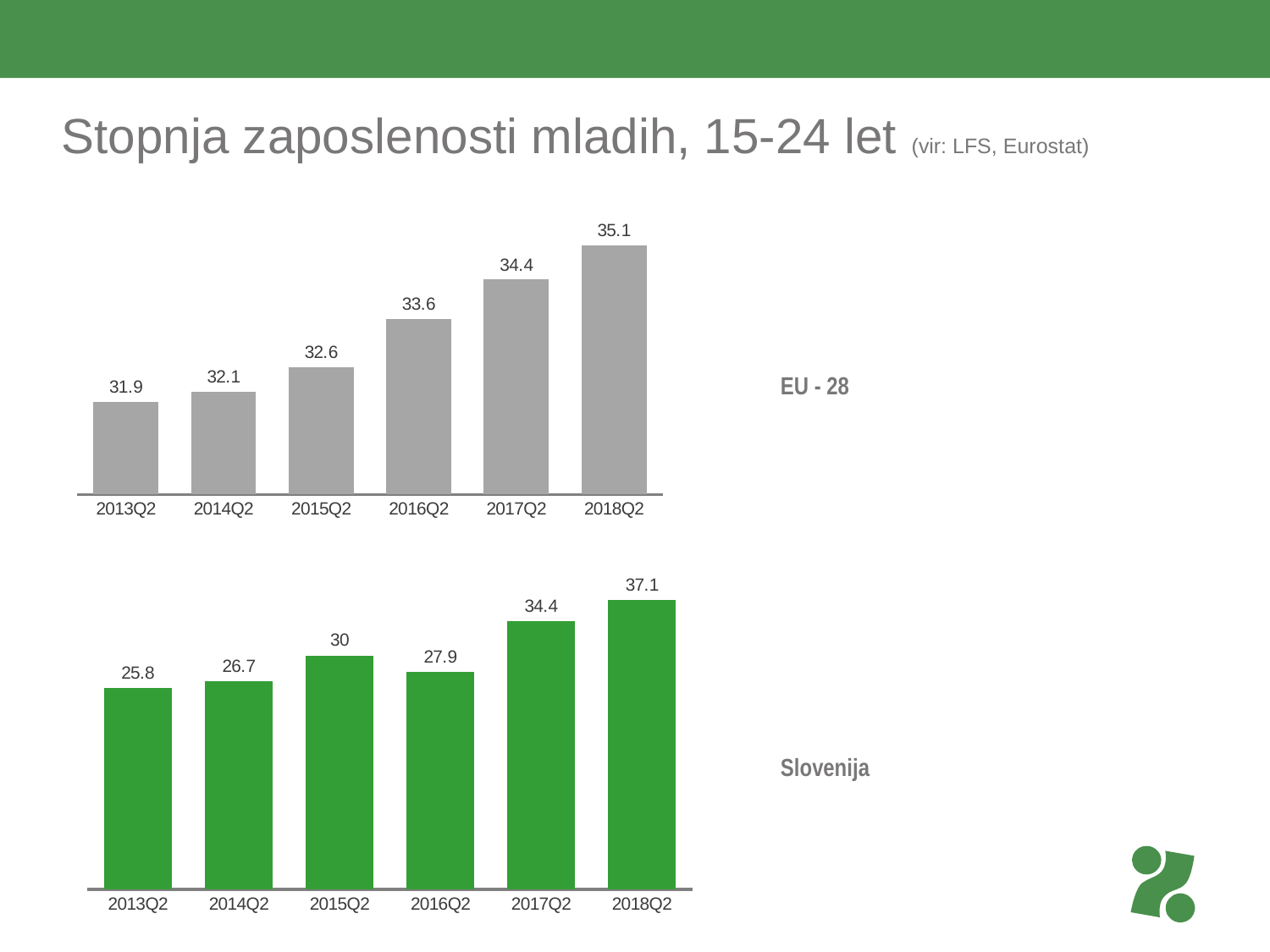
In the Slovenija chart (bottom), which quarter has the highest value? 2018Q2 In the EU - 28 chart (top), do the values rise or fall from 2013Q2 to 2018Q2? Rise In the Slovenija chart (bottom), what is the value for 2015Q2? 30 In the EU - 28 chart (top), what is the difference between the 2018Q2 and 2017Q2 values? 0.7 In the EU - 28 chart (top), which quarter has the lowest value? 2013Q2 What is the title of the slide? Stopnja zaposlenosti mladih, 15-24 let In the Slovenija chart (bottom), what is the difference between the 2018Q2 and 2013Q2 values? 11.3 What kind of chart is the Slovenija chart (bottom)? Bar chart What colour are the bars in the Slovenija chart (bottom)? Green How many bars are in the EU - 28 chart (top)? 6 In the EU - 28 chart (top), what is the value for 2016Q2? 33.6 In the Slovenija chart (bottom), which is larger: the value for 2015Q2 or the value for 2016Q2? 2015Q2